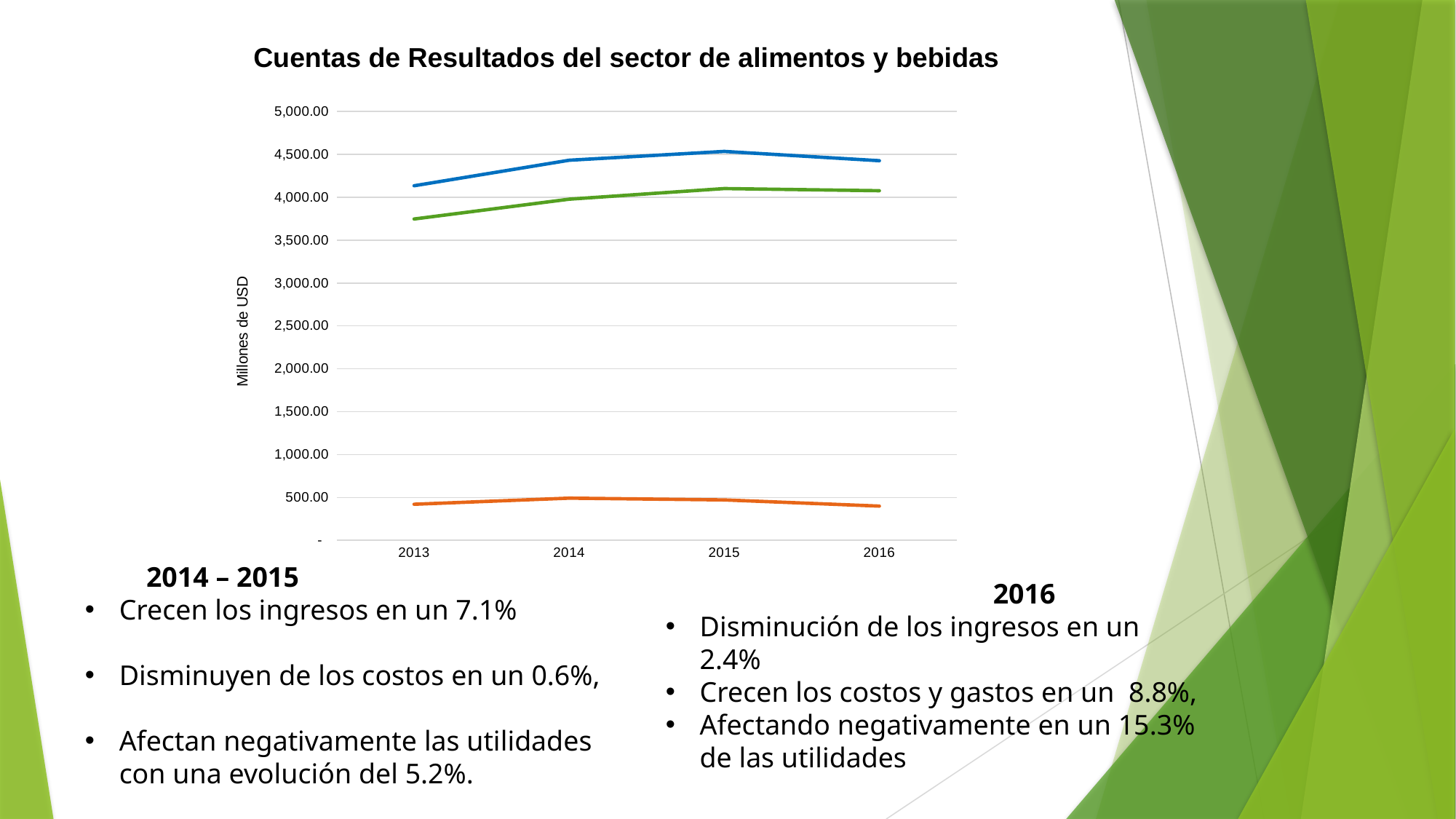
How many years are shown on the x axis of the chart? 4 What is the label on the vertical axis of the chart? Millones de USD Is the value of the blue line in 2013 greater or less than 4,000.00? greater Does the blue line rise or fall from 2013 to 2015? rise In which year does the blue line reach its highest value? 2015 Is the value of the green line in 2013 greater or less than 4,000.00? less What kind of chart is shown on the slide? line chart In which year does the green line have its lowest value? 2013 What is the title of the chart? Cuentas de Resultados del sector de alimentos y bebidas How many lines are plotted on the chart? 3 Is the value of the orange line in 2016 greater or less than 500.00? less